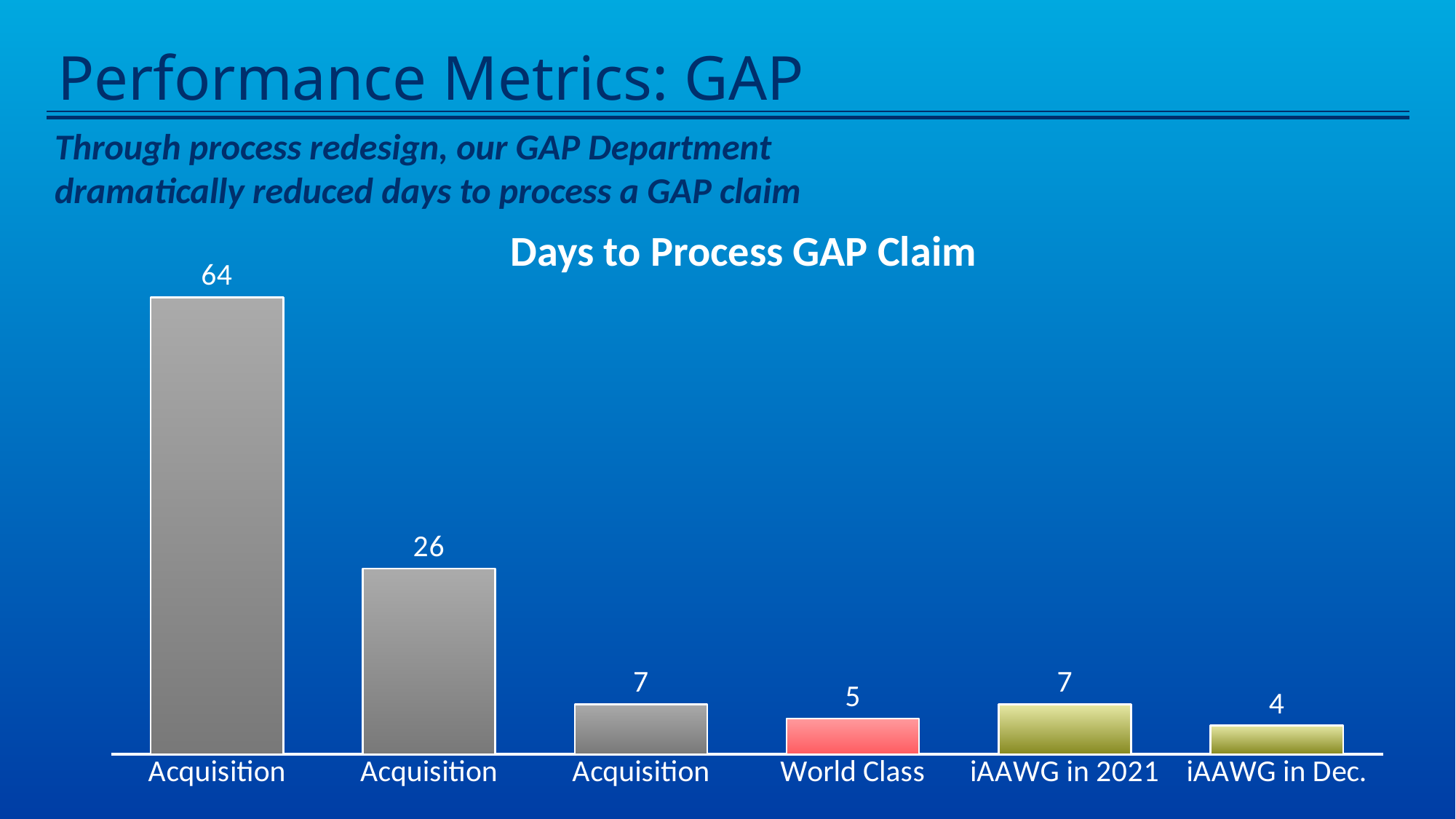
What is the difference between the first and second bars from the left in the Days to Process GAP Claim chart? 38 What is the difference between iAAWG in 2021 and iAAWG in Dec. in the Days to Process GAP Claim chart? 3 What is the value for iAAWG in Dec. in the Days to Process GAP Claim chart? 4 What is the value of the second bar from the left in the Days to Process GAP Claim chart? 26 What is the value for iAAWG in 2021 in the Days to Process GAP Claim chart? 7 Which category has the lowest value in the Days to Process GAP Claim chart? iAAWG in Dec. What kind of chart is shown on the slide? Bar chart How many bars are shown in the Days to Process GAP Claim chart? 6 Which is larger in the Days to Process GAP Claim chart, World Class or iAAWG in 2021? iAAWG in 2021 What is the value for World Class in the Days to Process GAP Claim chart? 5 What is the title of the chart on the slide? Days to Process GAP Claim What is the value of the first bar from the left in the Days to Process GAP Claim chart? 64